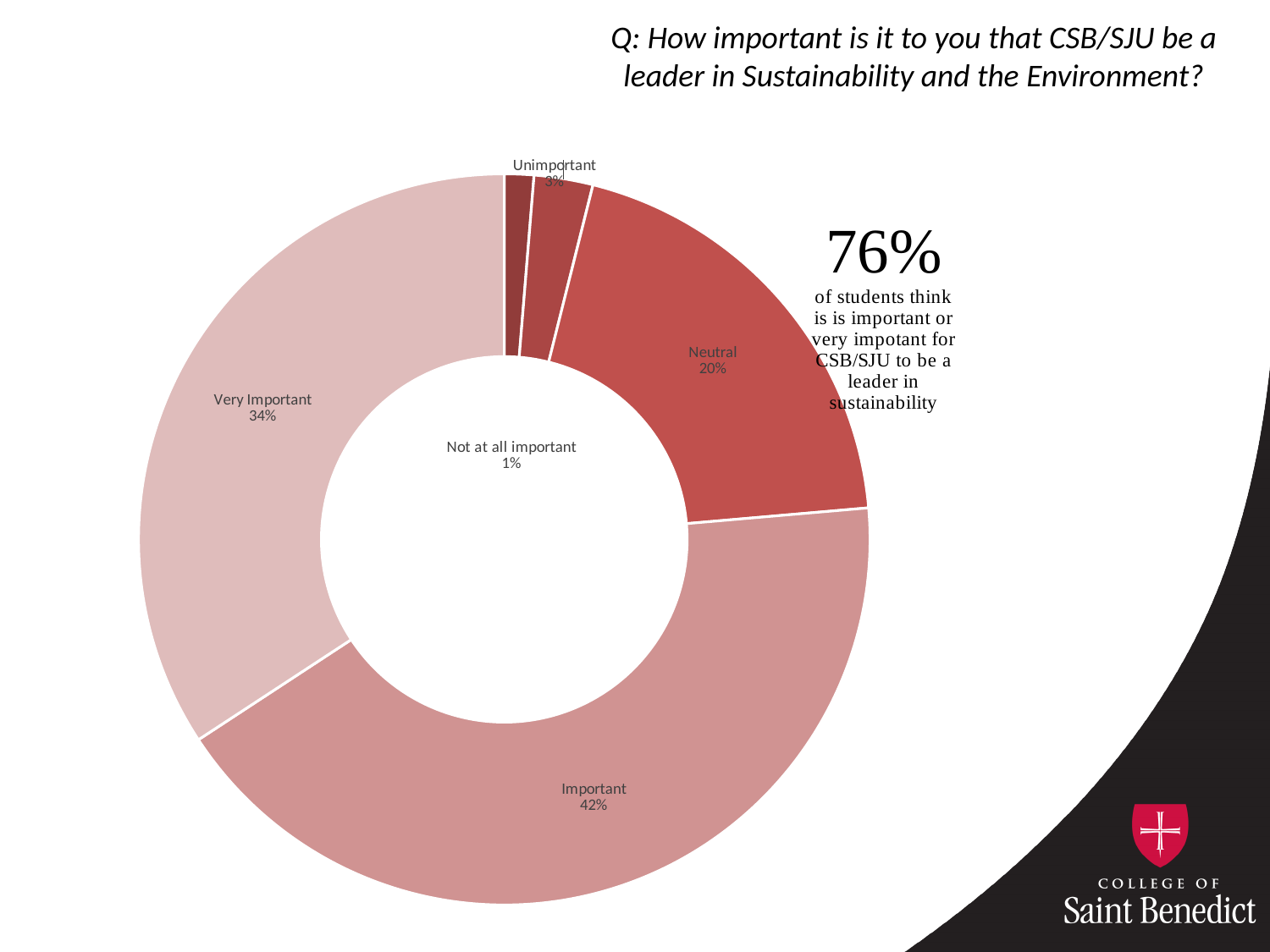
Which response category has the smallest share of the chart? Not at all important What survey question does the chart on the slide answer? How important is it to you that CSB/SJU be a leader in Sustainability and the Environment? What percentage of students answered "Important"? 42% What kind of chart is shown on the slide? Doughnut chart How many percentage points larger is the "Important" share than the "Very Important" share? 8 percentage points How many response categories are shown in the chart? 5 Which is larger, the "Neutral" share or the "Very Important" share? Very Important What percentage of students answered "Not at all important"? 1% What is the combined share of "Important" and "Very Important" responses? 76% Which response category has the largest share of the chart? Important What share of responses is labelled "Neutral"? 20% What percentage of students answered "Very Important"? 34%